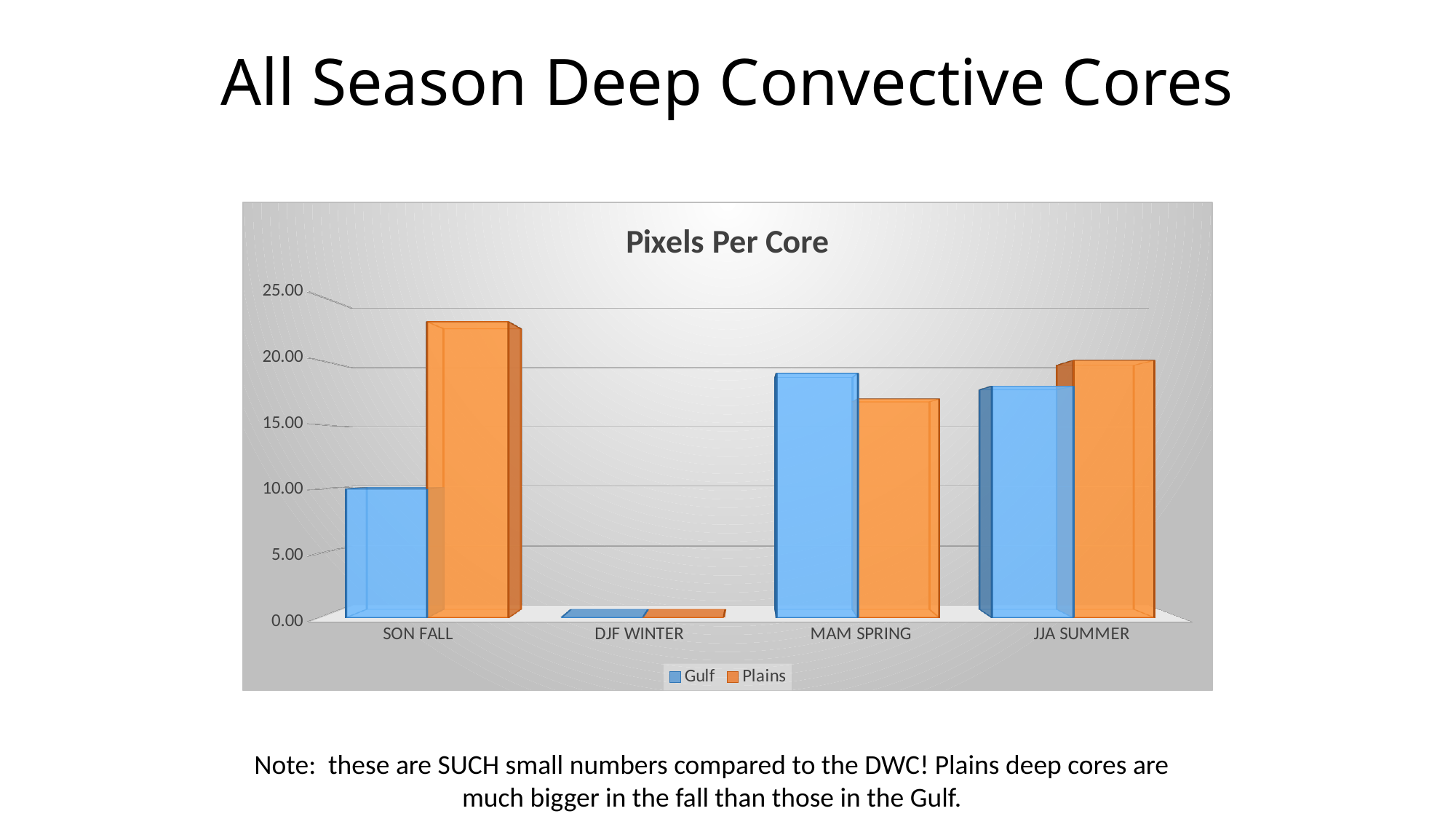
In SON FALL, which is larger, Gulf or Plains? Plains In MAM SPRING, which is larger, Gulf or Plains? Gulf Is the Gulf value for MAM SPRING greater or less than 15.00? greater In which season is the Plains value highest? SON FALL Is the Gulf value for DJF WINTER greater or less than 5.00? less Is the Plains value for SON FALL greater or less than 20.00? greater What is the title of the chart? Pixels Per Core What kind of chart is shown on the slide? bar chart Which series is shown in orange? Plains How many series does the legend list? 2 How many season categories are shown on the x axis? 4 In which season is the Gulf value lowest? DJF WINTER